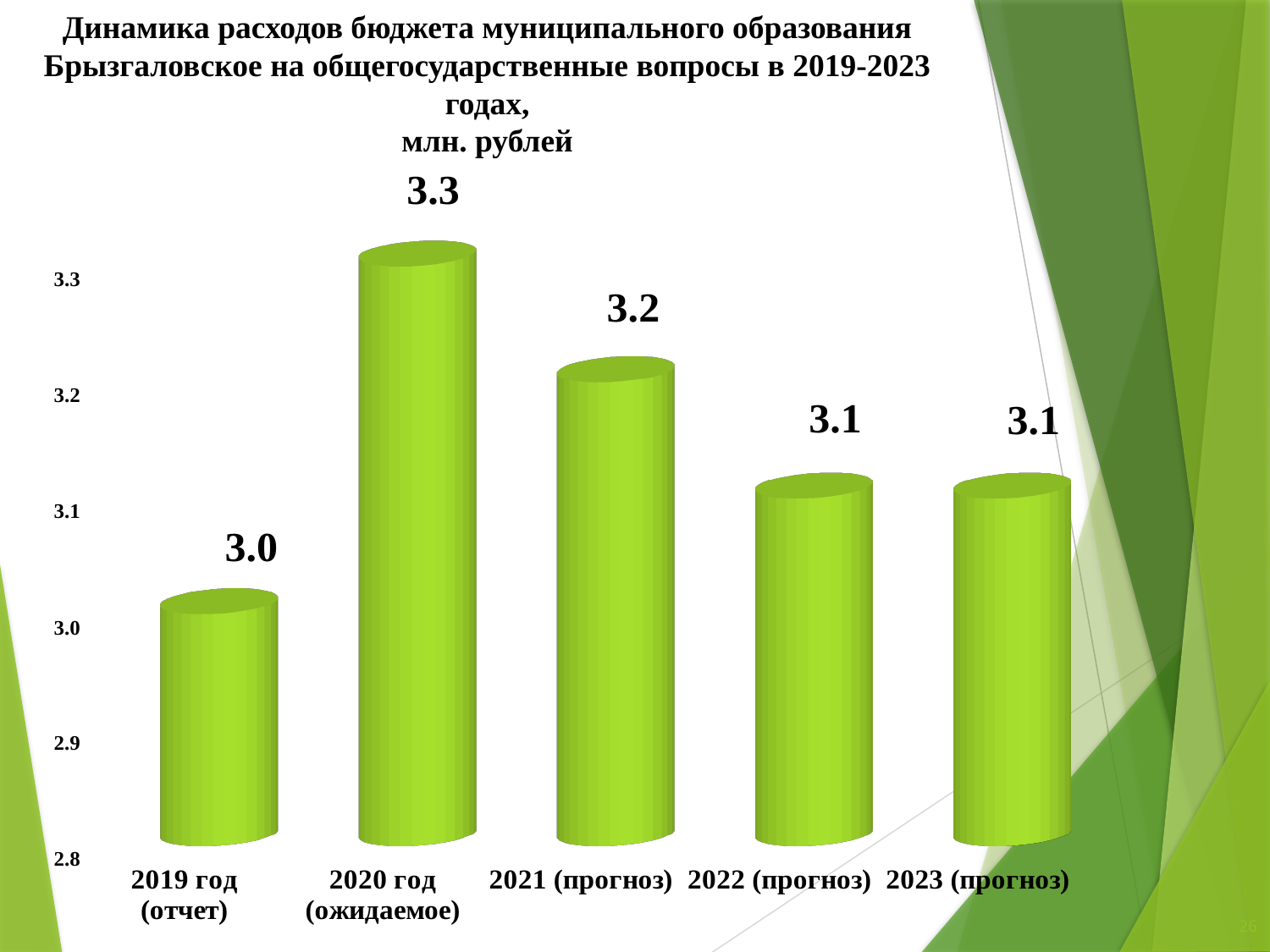
In what units are the values on the chart expressed, according to the title? млн. рублей What is the difference between the values for 2020 год (ожидаемое) and 2019 год (отчет)? 0.3 What is the value for 2020 год (ожидаемое)? 3.3 Which category has the highest value? 2020 год (ожидаемое) What is the value for 2019 год (отчет)? 3.0 Which category has the lowest value? 2019 год (отчет) What kind of chart is shown on the slide? bar chart What is the value for 2021 (прогноз)? 3.2 What is the value for 2023 (прогноз)? 3.1 How many categories are shown on the chart? 5 Do the values rise or fall from 2020 год (ожидаемое) to 2022 (прогноз)? fall Which is larger, the value for 2021 (прогноз) or the value for 2022 (прогноз)? 2021 (прогноз)